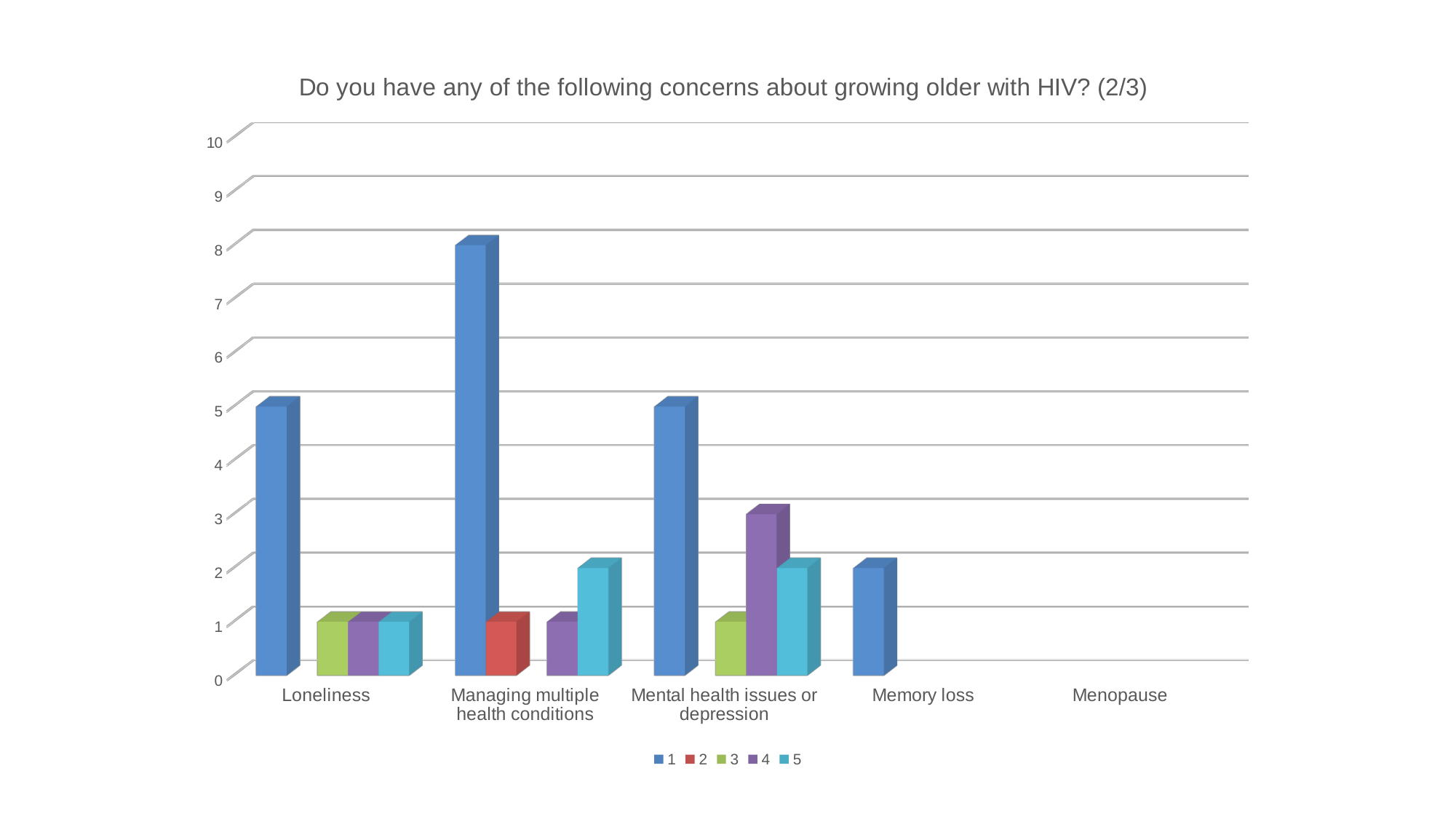
Which is larger: series 1 for Loneliness or series 1 for Memory loss? Loneliness Is the value for series 1 in the Memory loss category greater or less than 5? less How many categories are shown on the x axis? 5 What is the value for series 1 in the Loneliness category? 5 How many series does the legend list? 5 Which category has the highest bar for series 1? Managing multiple health conditions What is the value for series 1 in the Managing multiple health conditions category? 8 Is the value for series 4 in the Mental health issues or depression category greater or less than 2? greater Which category has no bars plotted at all? Menopause Which series is shown in red in the legend? 2 What kind of chart is shown on the slide? bar chart What is the title of the chart? Do you have any of the following concerns about growing older with HIV? (2/3)